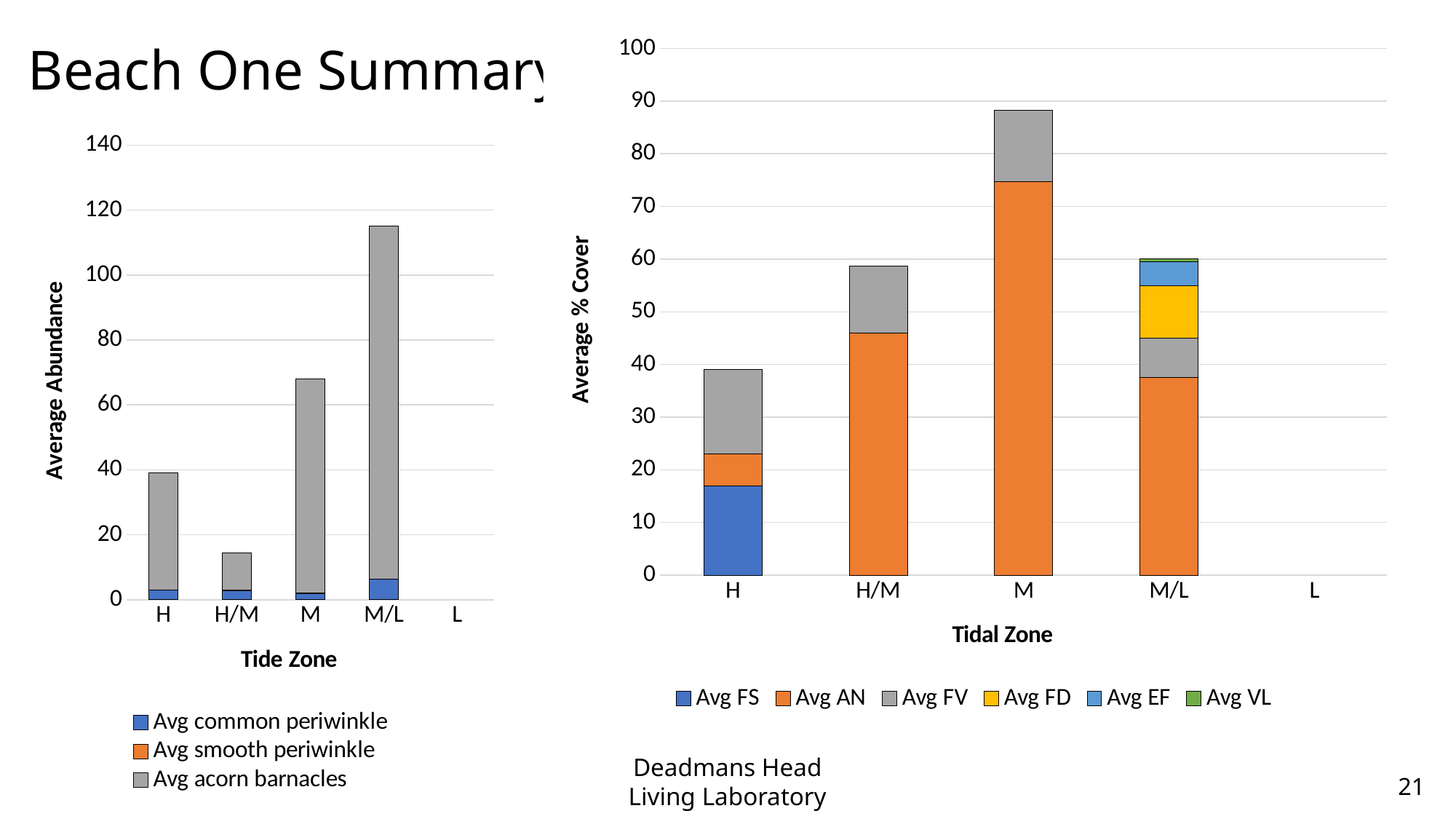
On the left chart (Average Abundance), how many tide zone categories are shown on the x axis? 5 On the left chart (Average Abundance), is the total value for M/L greater or less than 100? greater On the left chart (Average Abundance), how many series does the legend list? 3 On the right chart (Average % Cover), how many series does the legend list? 6 On the left chart (Average Abundance), which tide zone has the highest total bar? M/L On the right chart (Average % Cover), what is the label of the x axis? Tidal Zone On the left chart (Average Abundance), is the total value for M greater or less than 60? greater What kind of chart is the right chart (Average % Cover)? Stacked bar chart On the left chart (Average Abundance), is the total value for H/M greater or less than 20? less On the right chart (Average % Cover), which tidal zone has the highest total bar? M